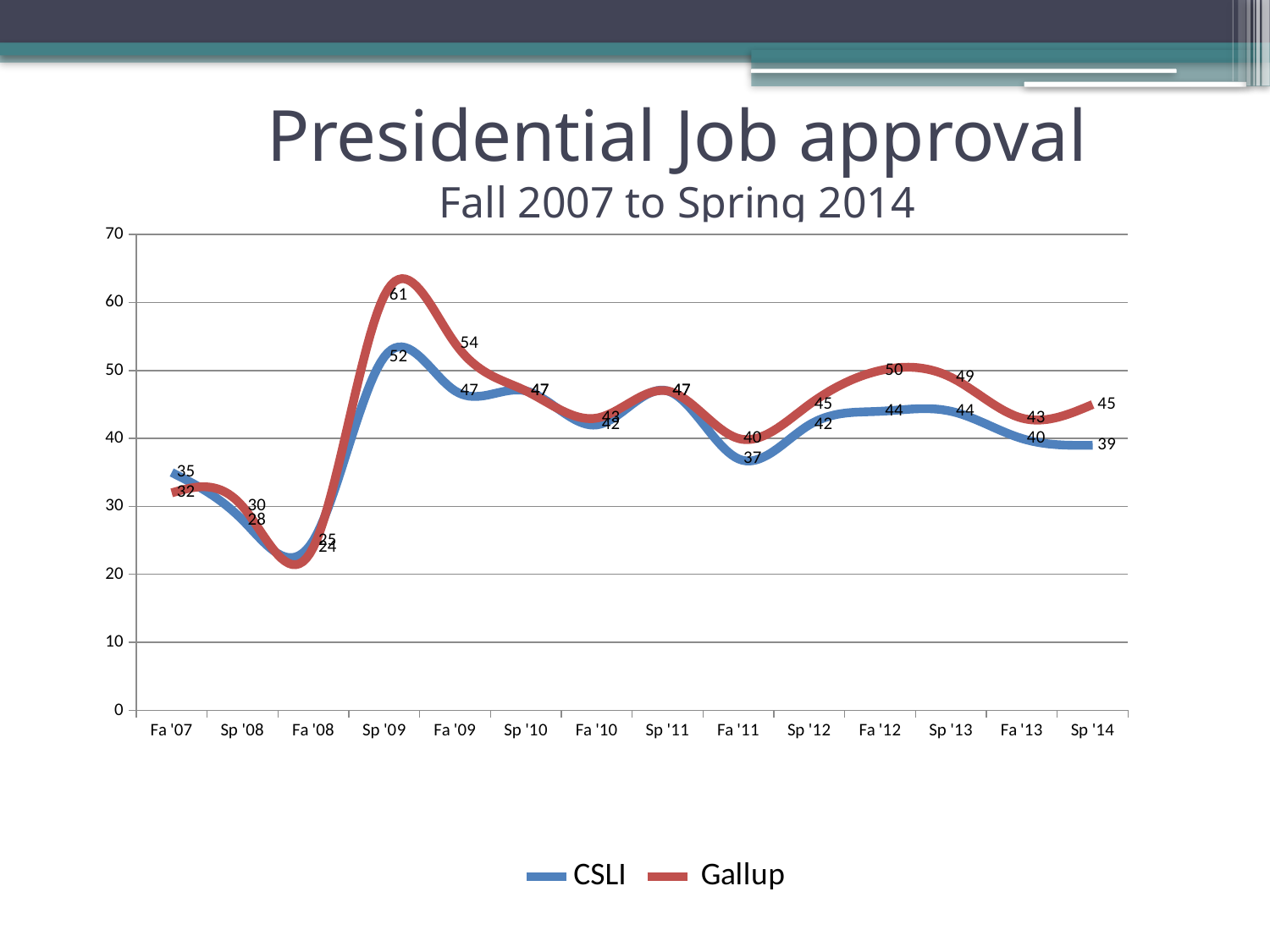
At which time point does the CSLI series reach its lowest value? Fa '08 What is the CSLI value for Sp '14? 39 Do the values rise or fall from Fa '07 to Fa '08? fall What is the Gallup value for Sp '09? 61 What colour is the Gallup line in the legend? red What is the CSLI value for Fa '11? 37 How many series does the legend list? 2 What is the difference between the Gallup and CSLI values at Sp '09? 9 How many time points are plotted along the x axis? 14 At which time point does the Gallup series reach its highest value? Sp '09 At Fa '12, which series has the higher value, CSLI or Gallup? Gallup What kind of chart is shown on the slide? line chart